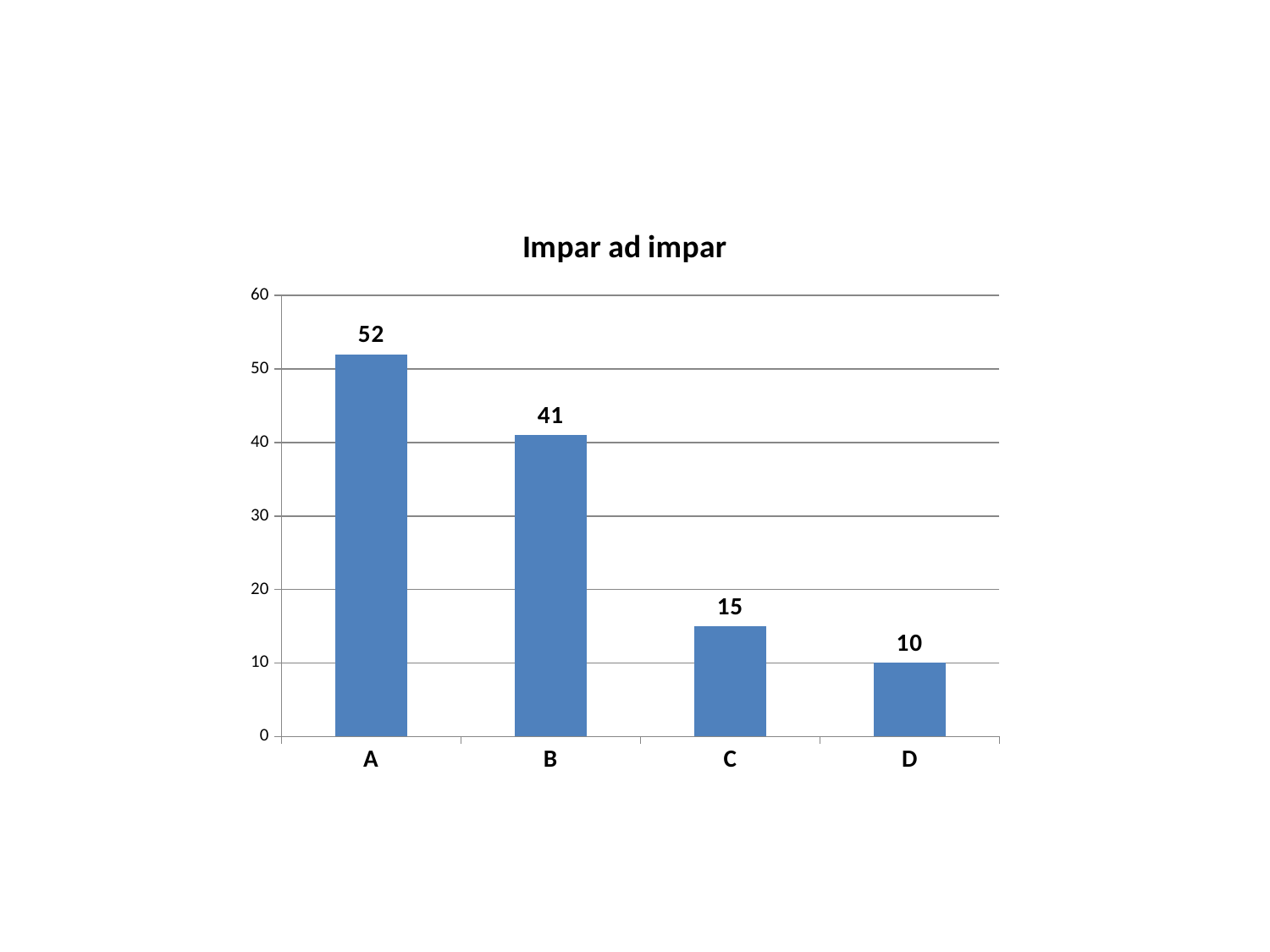
Which is larger, the value for B or the value for C? B Which category has the lowest value? D What is the difference between the values for A and B? 11 What is the value for category C? 15 What is the title of the chart? Impar ad impar What kind of chart is shown on the slide? Bar chart What is the value for category B? 41 What is the value for category D? 10 What is the value for category A? 52 What is the difference between the values for C and D? 5 Which category has the highest value? A How many categories are shown on the x axis? 4